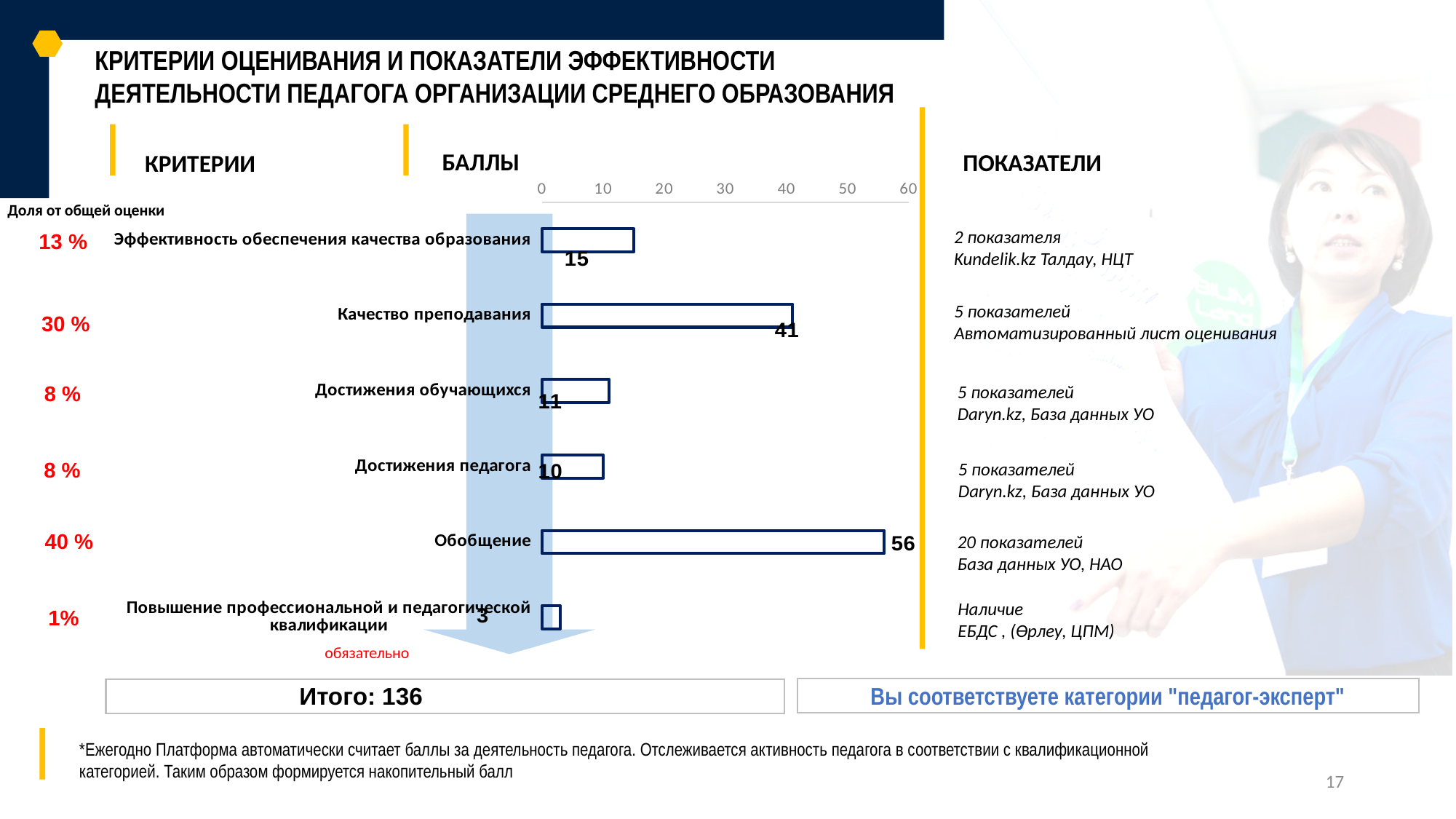
What is the value for Повышение профессиональной и педагогической квалификации? 3 Which category has the highest value? Обобщение What is the difference between the values for Обобщение and Качество преподавания? 15 What is the maximum value shown on the horizontal axis of the chart? 60 How many categories does the bar chart show? 6 What type of chart is shown on the slide? bar chart What is the value for Достижения обучающихся? 11 Which is larger, the value for Эффективность обеспечения качества образования or the value for Достижения педагога? Эффективность обеспечения качества образования What is the value for Обобщение? 56 What is the value for Качество преподавания? 41 Is the value for Качество преподавания greater or less than 30? greater Which category has the lowest value? Повышение профессиональной и педагогической квалификации